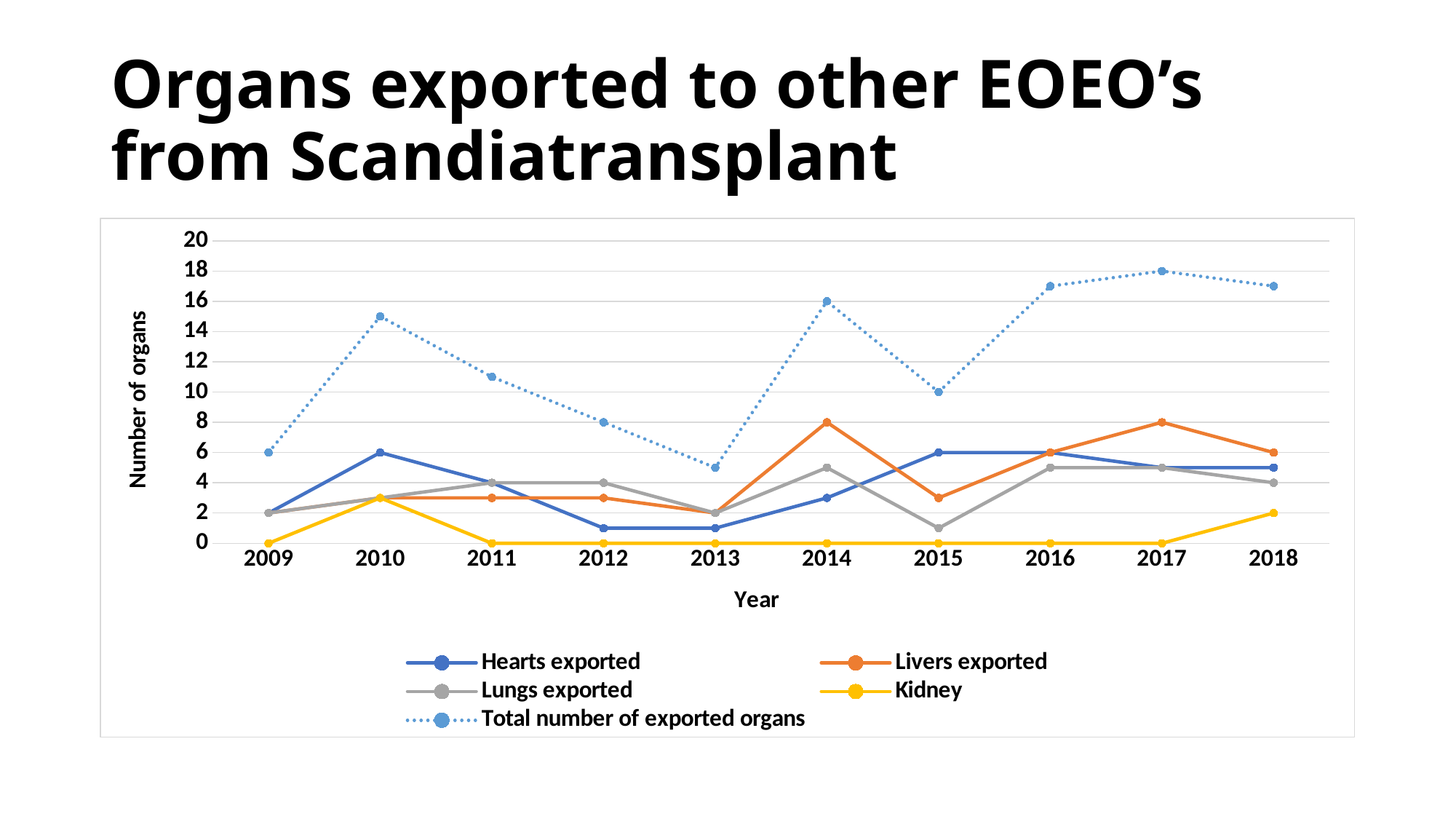
How many years are plotted along the x axis? 10 What is the difference between the total number of exported organs in 2017 and in 2015? 8 How many kidneys were exported in 2018? 2 How many lungs were exported in 2012? 4 How many livers were exported in 2014? 8 Is the total number of exported organs in 2010 greater or less than 14? greater What kind of chart is shown on the slide? line chart Which is larger, the total number of exported organs in 2014 or in 2015? 2014 Does the total number of exported organs rise or fall from 2010 to 2013? fall What is the total number of exported organs in 2017? 18 How many hearts were exported in 2010? 6 How many series does the legend list? 5